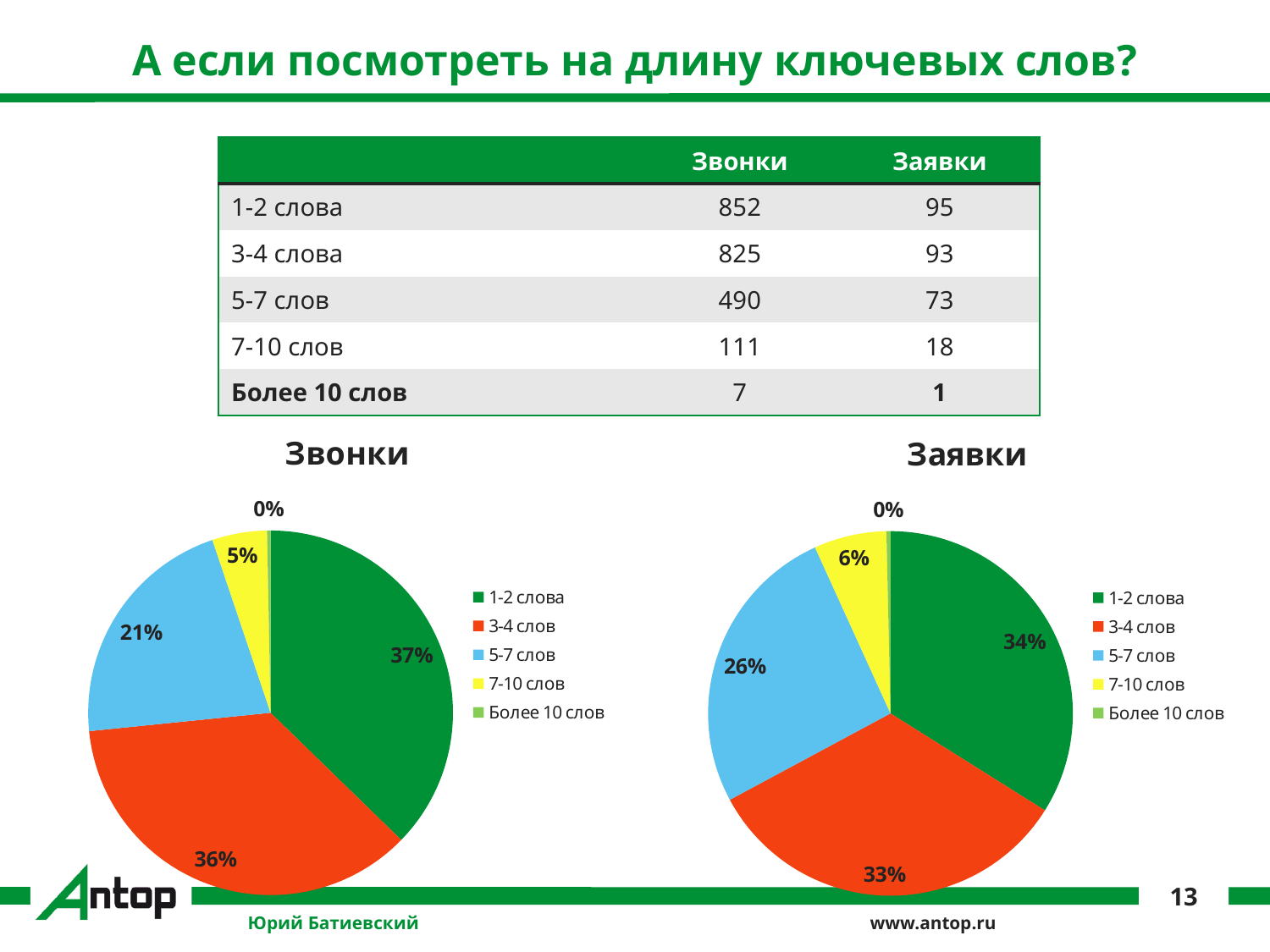
In the "Заявки" pie chart, what share does the "7-10 слов" slice have? 6% In the "Звонки" pie chart, what is the difference between the "3-4 слов" share and the "5-7 слов" share? 15% In the "Звонки" pie chart, what share does the "5-7 слов" slice have? 21% What kind of chart is the "Звонки" chart? pie chart In the "Звонки" pie chart, what colour is the "5-7 слов" slice? light blue In the "Заявки" pie chart, which slice is larger: "5-7 слов" or "7-10 слов"? 5-7 слов In the "Заявки" pie chart, what share does the "3-4 слов" slice have? 33% In the "Звонки" pie chart, which category has the smallest slice? Более 10 слов What is the title of the pie chart on the right side of the slide? Заявки In the "Заявки" pie chart, which category has the largest slice? 1-2 слова How many categories does the legend of the "Заявки" pie chart list? 5